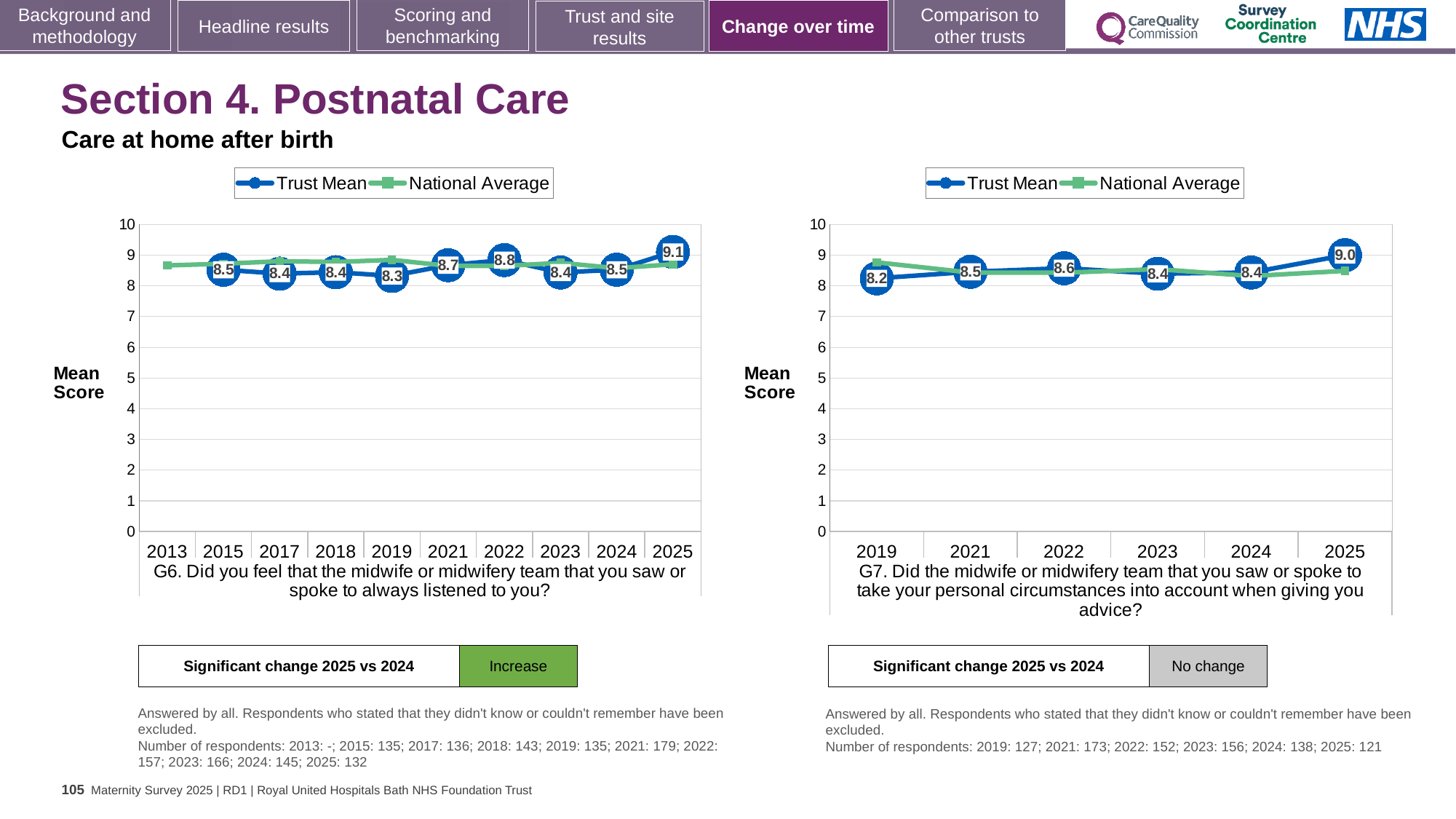
In the right chart (G7), what is the Trust Mean for 2025? 9.0 What kind of chart is the right chart (G7)? line chart In the left chart (G6), what is the Trust Mean for 2019? 8.3 In the right chart (G7), which year has the lowest Trust Mean? 2019 In the right chart (G7), is the Trust Mean for 2022 larger or smaller than the Trust Mean for 2019? larger In the left chart (G6), how many series does the legend list? 2 In the left chart (G6), what is the Trust Mean for 2025? 9.1 In the right chart (G7), what is the Trust Mean for 2019? 8.2 In the left chart (G6), what is the difference between the Trust Mean in 2025 and in 2024? 0.6 In the right chart (G7), how many years are shown on the x axis? 6 In the left chart (G6), which year has the highest Trust Mean? 2025 In the left chart (G6), which year has the lowest labelled Trust Mean? 2019